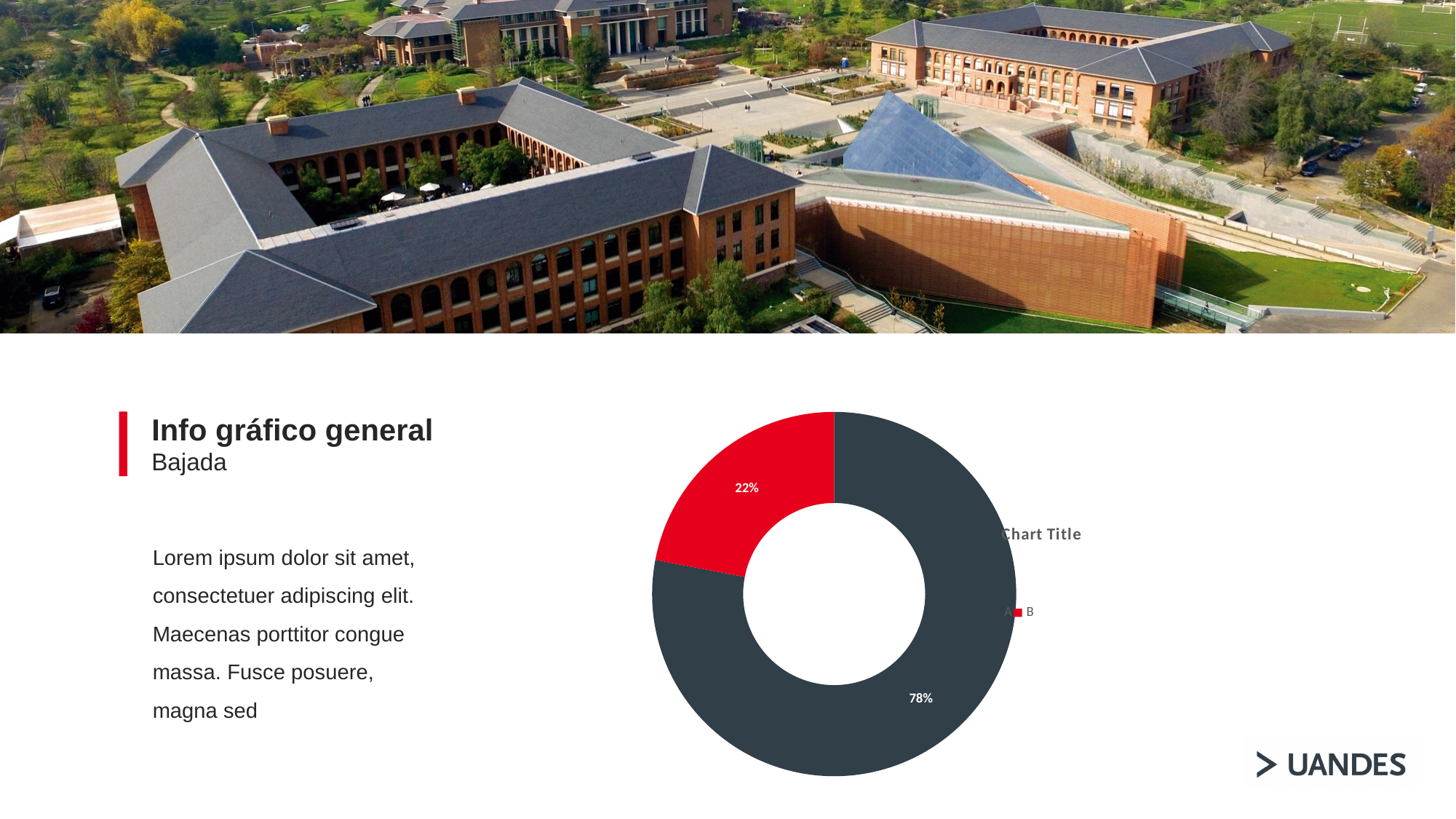
What is the title shown on the chart? Chart Title What is the difference in percentage points between the 78% slice and the 22% slice? 56 How many entries does the chart legend list? 2 What is the share of the slice labelled B in the chart? 22% Which slice is the largest in the chart? A (78%) How many slices does the doughnut chart have? 2 Which colour is used for legend entry B in the chart? red Which slice is the smallest in the chart? B (22%) What kind of chart is shown on the slide? doughnut chart What percentage is shown on the dark grey slice of the chart? 78% What is the share of the slice labelled A in the chart? 78% What percentage is shown on the red slice of the chart? 22%